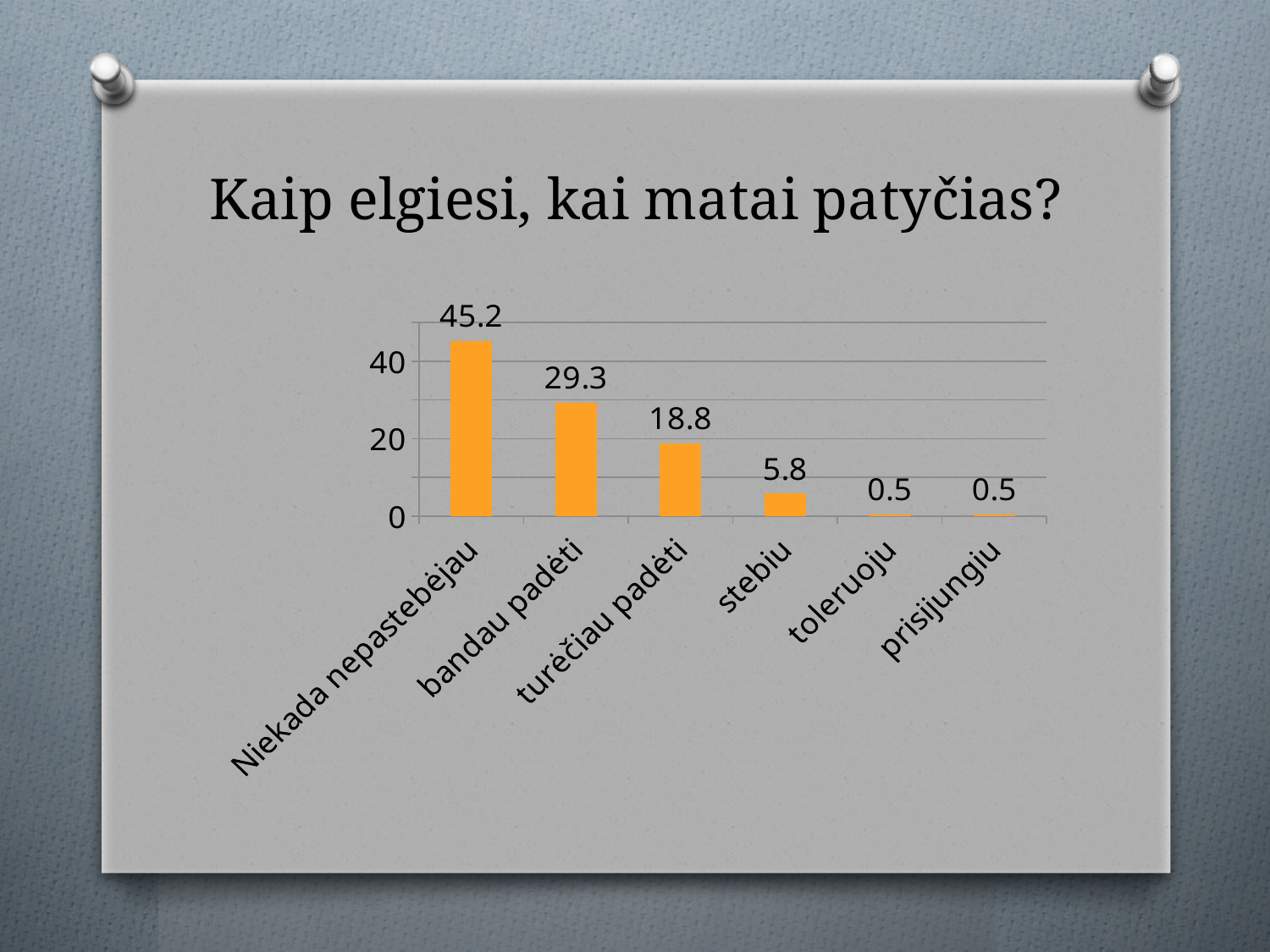
What is the value for "bandau padėti"? 29.3 What is the value for "Niekada nepastebėjau"? 45.2 How many categories are shown on the x axis? 6 What is the title of the slide? Kaip elgiesi, kai matai patyčias? What is the value for "toleruoju"? 0.5 Which is larger, the value for "turėčiau padėti" or the value for "stebiu"? turėčiau padėti Which category has the highest value? Niekada nepastebėjau What kind of chart is shown on the slide? bar chart What is the value for "turėčiau padėti"? 18.8 What is the value for "stebiu"? 5.8 Is the value for "bandau padėti" greater or less than 20? greater What is the difference between the values for "Niekada nepastebėjau" and "bandau padėti"? 15.9